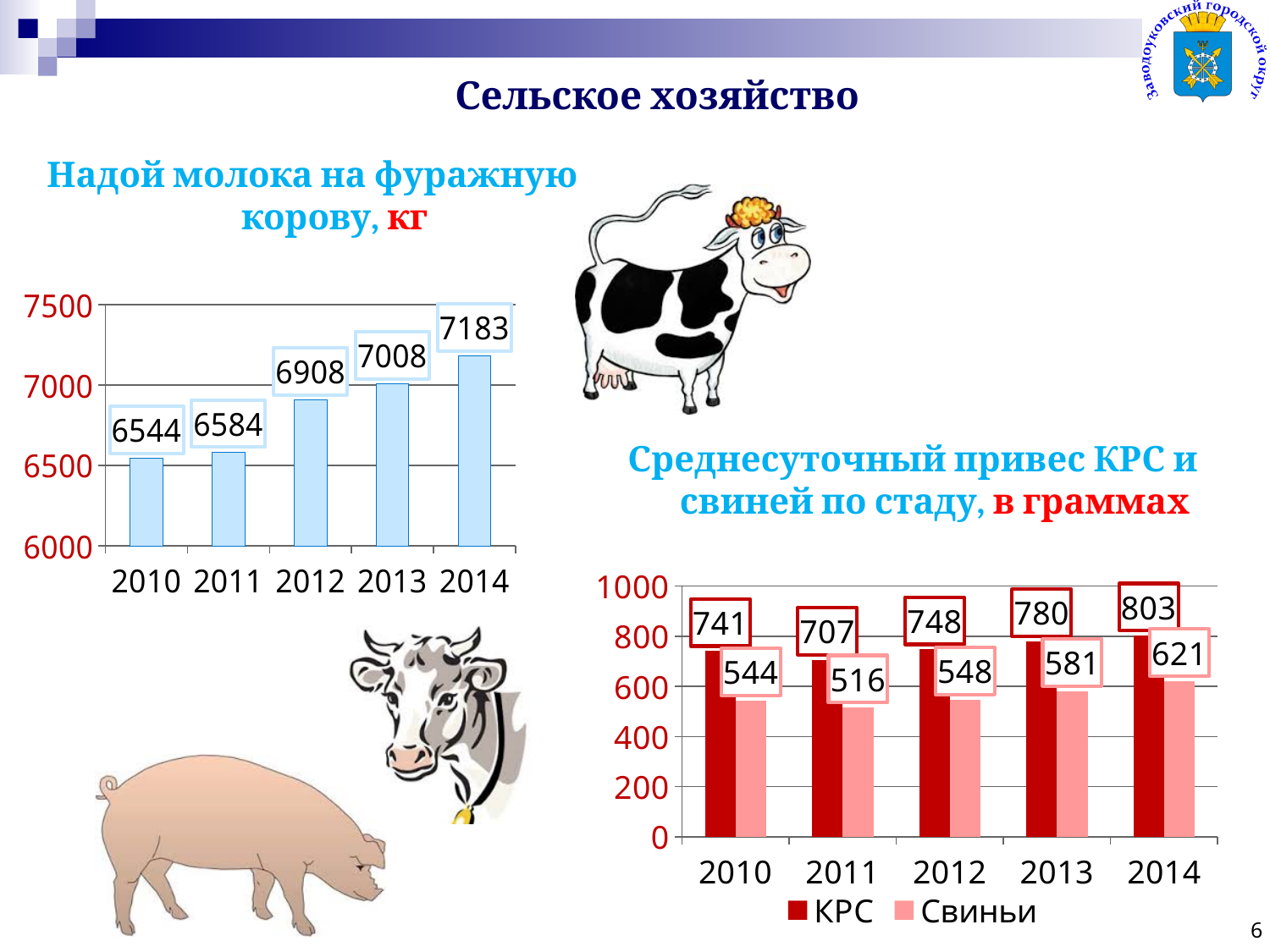
What kind of chart is 'Среднесуточный привес КРС и свиней по стаду, в граммах'? bar chart In the chart 'Среднесуточный привес КРС и свиней по стаду, в граммах', what is the value for Свиньи in 2011? 516 How many years are shown in the chart 'Надой молока на фуражную корову, кг'? 5 In the chart 'Надой молока на фуражную корову, кг', what is the difference between the 2014 and 2010 values? 639 How many series does the legend list in the chart 'Среднесуточный привес КРС и свиней по стаду, в граммах'? 2 In the chart 'Среднесуточный привес КРС и свиней по стаду, в граммах', which year has the lowest value for КРС? 2011 In the chart 'Надой молока на фуражную корову, кг', which year has the lowest value? 2010 In the chart 'Среднесуточный привес КРС и свиней по стаду, в граммах', what is the value for КРС in 2013? 780 In the chart 'Надой молока на фуражную корову, кг', do the values rise or fall from 2010 to 2014? rise In the chart 'Надой молока на фуражную корову, кг', what is the value for 2012? 6908 In the chart 'Среднесуточный привес КРС и свиней по стаду, в граммах', what is the difference between КРС and Свиньи in 2014? 182 In the chart 'Надой молока на фуражную корову, кг', which year has the highest value? 2014